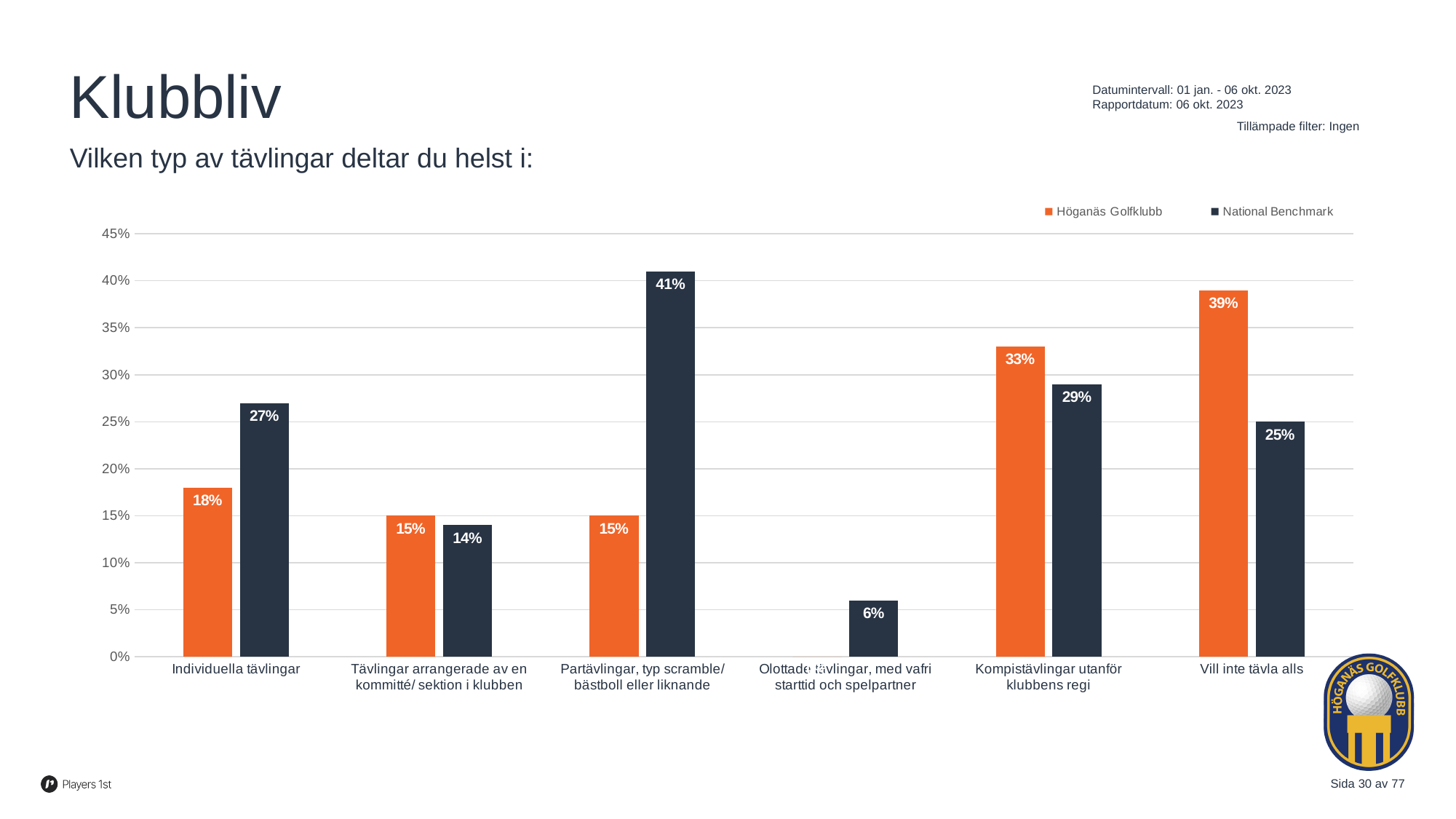
What type of chart is shown on the slide? Bar chart What is the Höganäs Golfklubb value for "Vill inte tävla alls"? 39% For "Kompistävlingar utanför klubbens regi", which series has the larger value, Höganäs Golfklubb or National Benchmark? Höganäs Golfklubb How many categories are shown on the x axis? 6 What is the value for Höganäs Golfklubb in the category "Individuella tävlingar"? 18% Which category has the highest National Benchmark value? Partävlingar, typ scramble/ bästboll eller liknande Which category has the lowest National Benchmark value? Olottade tävlingar, med vafri starttid och spelpartner Which category has the highest Höganäs Golfklubb value? Vill inte tävla alls What is the difference between the National Benchmark and Höganäs Golfklubb values for "Partävlingar, typ scramble/ bästboll eller liknande"? 26% What is the National Benchmark value for "Olottade tävlingar, med vafri starttid och spelpartner"? 6% How many series does the legend list? 2 What is the National Benchmark value for "Partävlingar, typ scramble/ bästboll eller liknande"? 41%